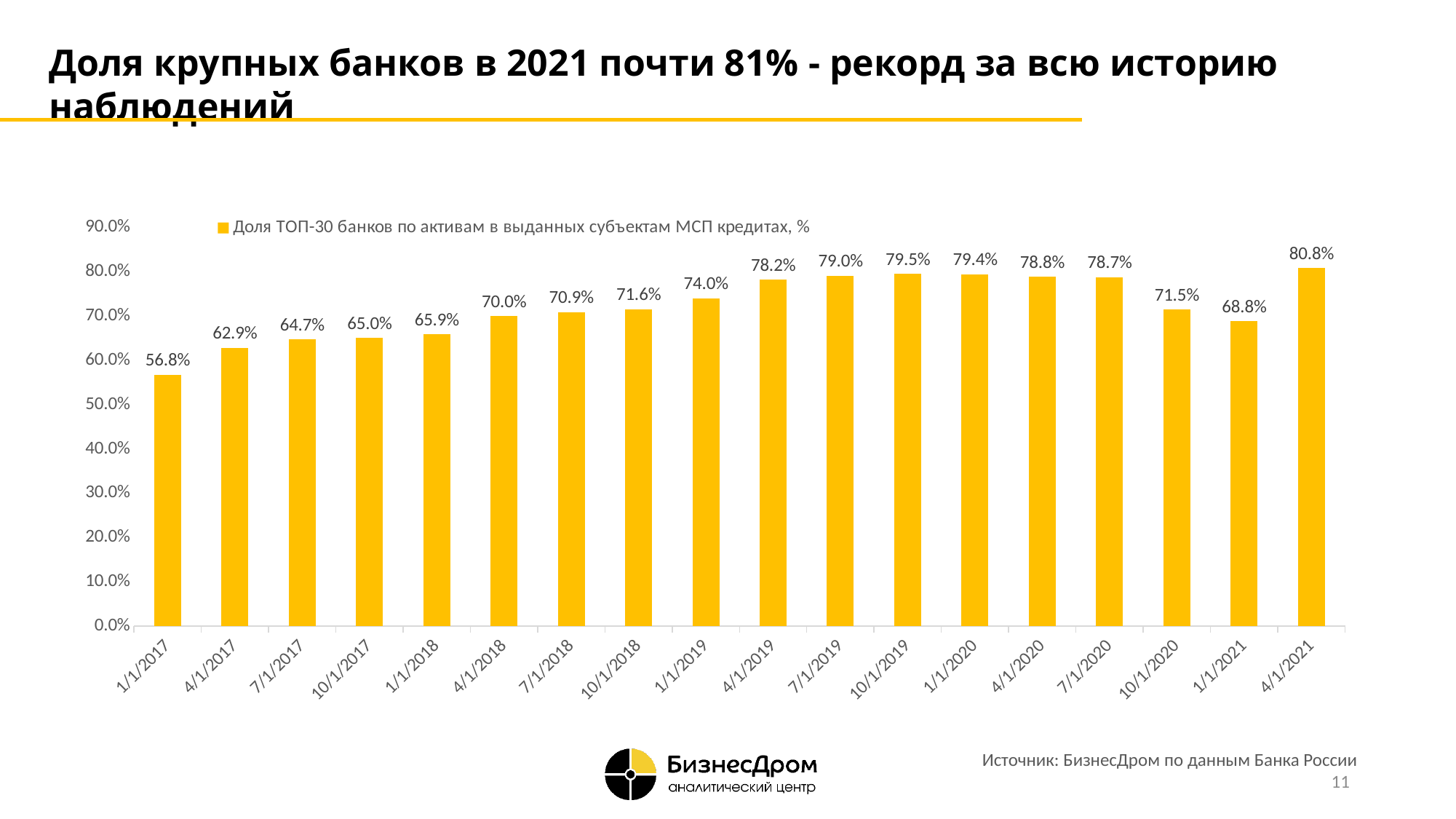
What is the difference between the values for 4/1/2021 and 1/1/2017? 24.0% Which date has the lowest value? 1/1/2017 What is the legend entry for the series? Доля ТОП-30 банков по активам в выданных субъектам МСП кредитах, % Which is larger, the value for 1/1/2021 or the value for 10/1/2020? 10/1/2020 Which date has the highest value? 4/1/2021 Is the value for 1/1/2019 greater or less than 70.0%? greater What is the value for 10/1/2020? 71.5% What is the value for 1/1/2017? 56.8% How many series does the legend list? 1 What is the value for 4/1/2021? 80.8% What kind of chart is shown? bar chart How many dates are shown on the x axis? 18